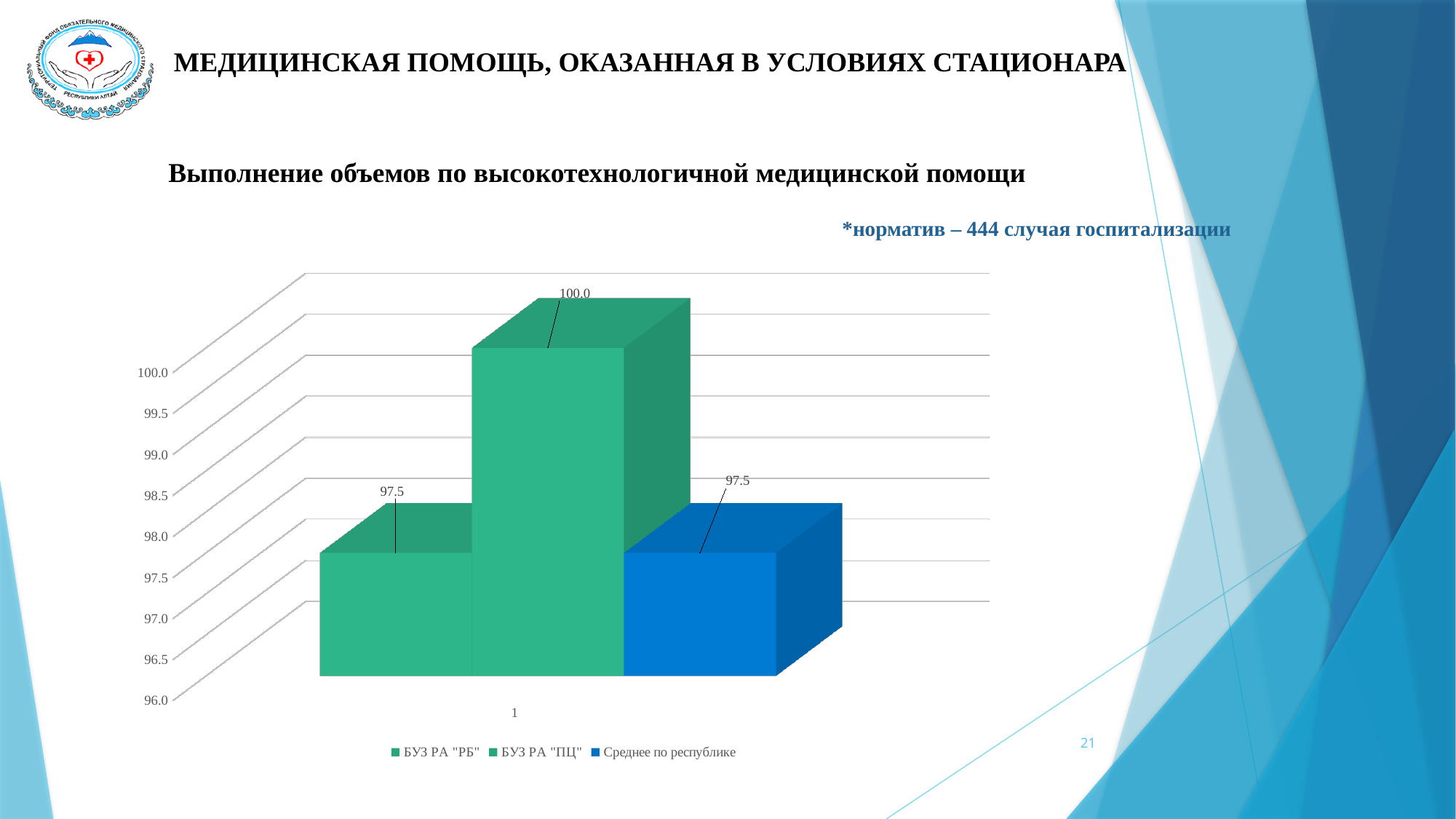
What kind of chart is shown on the slide? bar chart What is the value for БУЗ РА "ПЦ"? 100.0 Is the value for БУЗ РА "РБ" greater or less than 99.0? less What is the difference between the values for БУЗ РА "ПЦ" and БУЗ РА "РБ"? 2.5 What is the title of the chart? Выполнение объемов по высокотехнологичной медицинской помощи Which is larger, the value for БУЗ РА "ПЦ" or the value for Среднее по республике? БУЗ РА "ПЦ" What colour is the bar for Среднее по республике? blue Which series has the highest value? БУЗ РА "ПЦ" What is the value for Среднее по республике? 97.5 What is the lowest value shown on the vertical axis? 96.0 How many series does the legend list? 3 What is the value for БУЗ РА "РБ"? 97.5